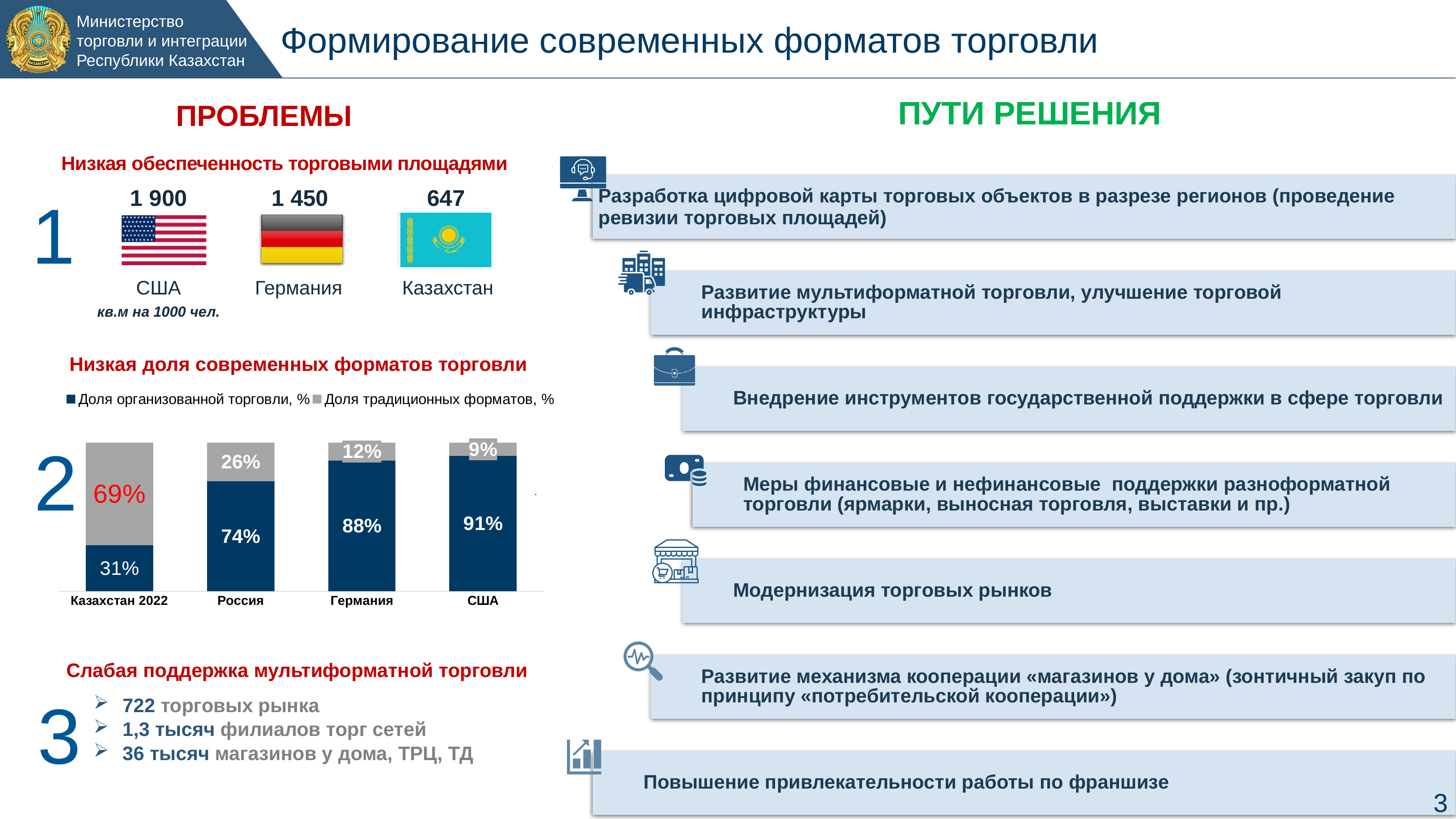
In the stacked bar chart, what is the value of «Доля традиционных форматов, %» for Казахстан 2022? 69% In the stacked bar chart, which is larger: «Доля традиционных форматов, %» for Россия or for Германия? Россия In the stacked bar chart, what is the value of «Доля организованной торговли, %» for США? 91% In the stacked bar chart, which category has the highest value of «Доля организованной торговли, %»? США In the stacked bar chart, which category has the lowest value of «Доля организованной торговли, %»? Казахстан 2022 In the stacked bar chart, what is the difference between the «Доля организованной торговли, %» values for США and Казахстан 2022? 60% How many series does the legend of the stacked bar chart list? 2 In the stacked bar chart, what is the value of «Доля организованной торговли, %» for Россия? 74% How many categories are shown on the x axis of the stacked bar chart? 4 In the stacked bar chart, what is the value of «Доля организованной торговли, %» for Казахстан 2022? 31% What kind of chart is shown under the heading «Низкая доля современных форматов торговли»? Stacked bar chart In the stacked bar chart, what is the value of «Доля традиционных форматов, %» for Германия? 12%